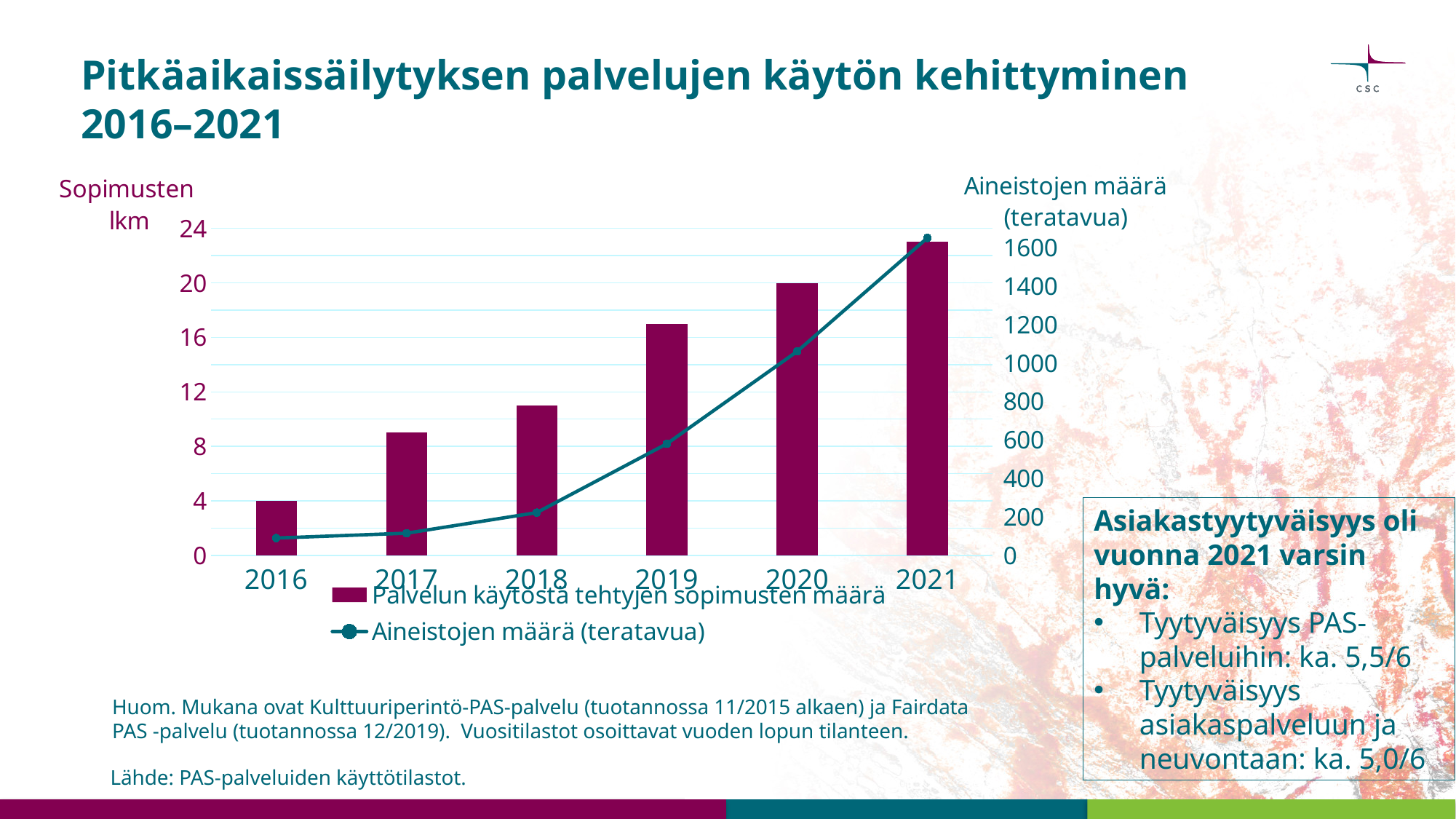
What is the number of agreements shown by the bar for 2020? 20 Is the amount of data (Aineistojen määrä, teratavua) for 2021 greater or less than 1600? greater Which year has a larger bar for the number of agreements, 2017 or 2019? 2019 Is the number of agreements for 2019 greater or less than 16? greater Does the amount of data (teratavua) line rise or fall from 2016 to 2021? rise Which year has the highest bar for the number of agreements? 2021 Which year has the lowest bar for the number of agreements? 2016 What is the number of agreements (Sopimusten lkm) shown by the bar for 2016? 4 How many years are shown on the x axis of the chart? 6 Is the amount of data (teratavua) for 2019 greater or less than 800? less How many series does the chart legend list? 2